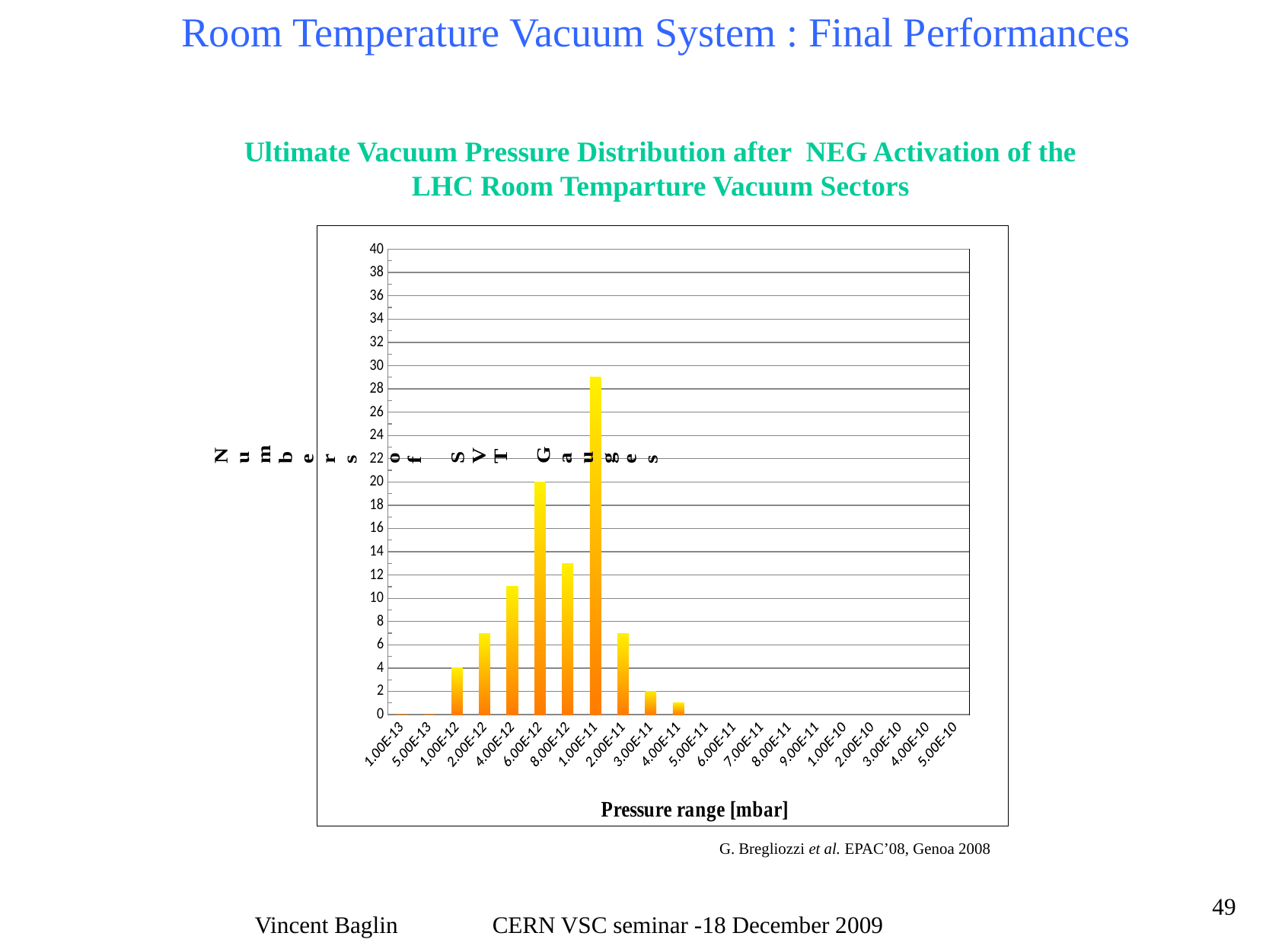
Is the value for 2.00E-12 greater or less than 10? less Which has more gauges, the 6.00E-12 range or the 8.00E-12 range? 6.00E-12 What kind of chart is shown on the slide? bar chart How many gauges are in the 6.00E-12 pressure range? 20 Is the value for 8.00E-12 greater or less than 10? greater How many pressure range categories are shown on the x axis? 21 What is the label of the x axis? Pressure range [mbar] How many gauges are in the 1.00E-12 pressure range? 4 How many gauges are in the 3.00E-11 pressure range? 2 What is the difference between the number of gauges at 6.00E-12 and at 1.00E-12? 16 Is the value for 1.00E-11 greater or less than 20? greater Which pressure range has the highest number of gauges? 1.00E-11